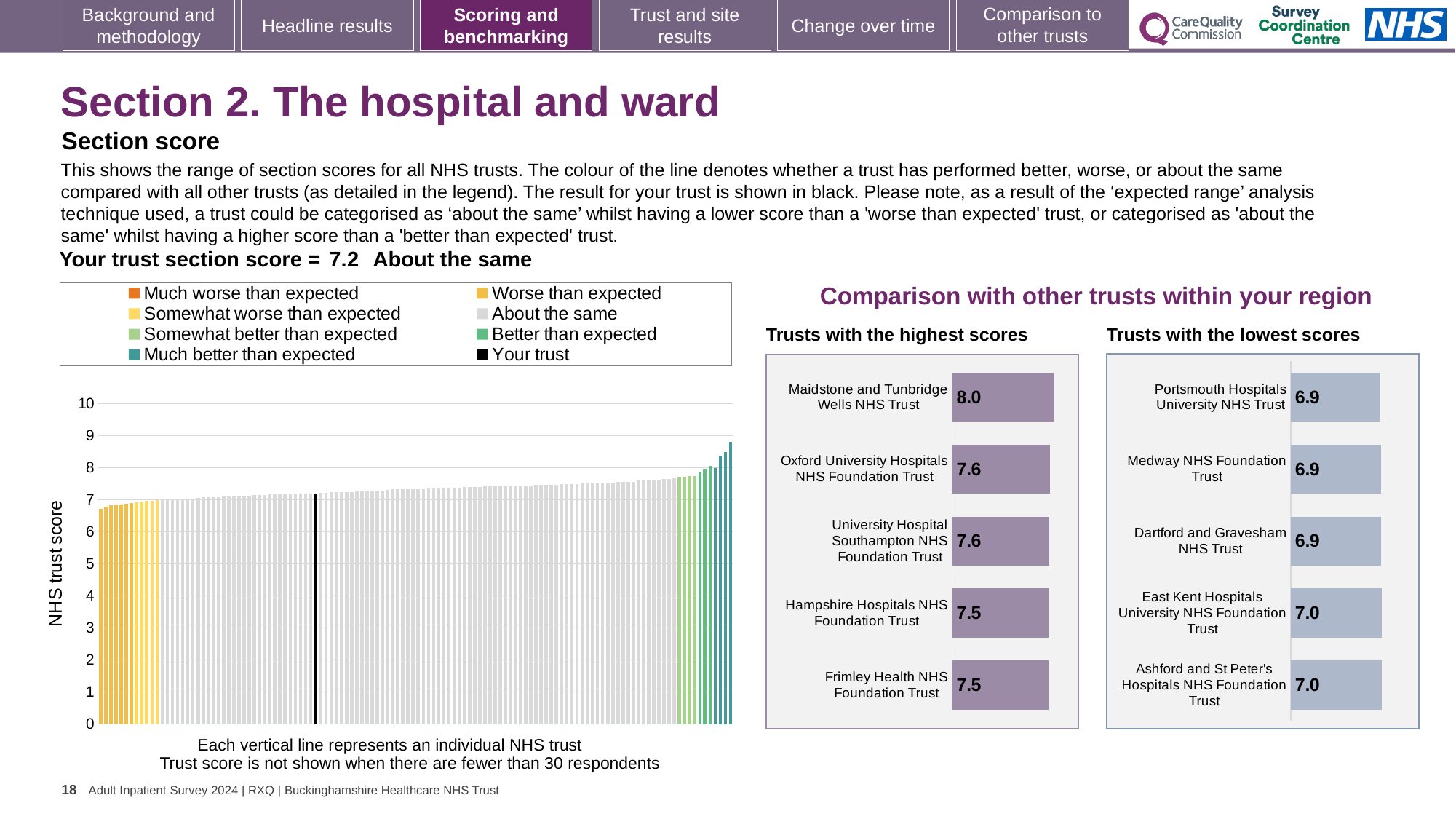
In the 'Trusts with the highest scores' chart, which trust has the highest score? Maidstone and Tunbridge Wells NHS Trust In the 'Trusts with the lowest scores' chart, what is the score for East Kent Hospitals University NHS Foundation Trust? 7.0 In the 'Trusts with the lowest scores' chart, which has the larger score: Ashford and St Peter's Hospitals NHS Foundation Trust or Medway NHS Foundation Trust? Ashford and St Peter's Hospitals NHS Foundation Trust What kind of chart is the 'Trusts with the lowest scores' chart? Bar chart In the NHS trust score chart on the left, what is the section score for your trust (shown in black)? 7.2 How many entries does the legend of the NHS trust score chart on the left list? 8 In the 'Trusts with the highest scores' chart, what is the score for Maidstone and Tunbridge Wells NHS Trust? 8.0 In the 'Trusts with the highest scores' chart, what is the difference between the scores of Maidstone and Tunbridge Wells NHS Trust and Frimley Health NHS Foundation Trust? 0.5 How many trusts are shown in the 'Trusts with the highest scores' chart? 5 In the 'Trusts with the lowest scores' chart, what is the difference between the scores of East Kent Hospitals University NHS Foundation Trust and Dartford and Gravesham NHS Trust? 0.1 In the 'Trusts with the lowest scores' chart, what is the score for Portsmouth Hospitals University NHS Trust? 6.9 In the 'Trusts with the highest scores' chart, what is the score for Hampshire Hospitals NHS Foundation Trust? 7.5